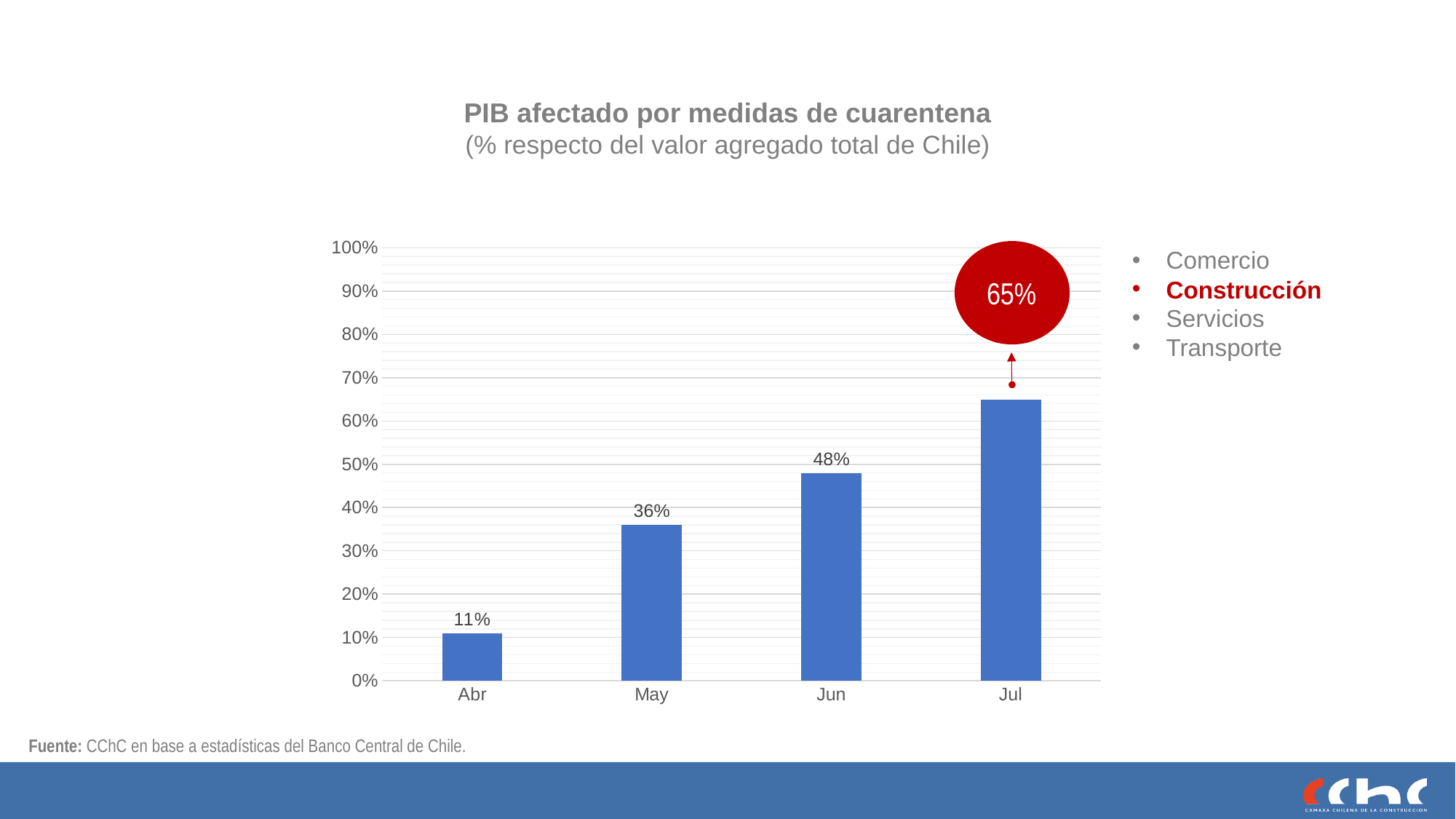
Which is larger, the value for May or the value for Jun? Jun Which month has the lowest value? Abr What is the value for Abr? 11% How many months are shown on the x axis? 4 Which month has the highest value? Jul What is the difference between the values for Jul and Abr? 54% What is the value for Jul? 65% Do the values rise or fall from Abr to Jul? Rise What is the value for May? 36% What is the value for Jun? 48% What is the difference between the values for Jun and May? 12% What kind of chart is shown on the slide? Bar chart